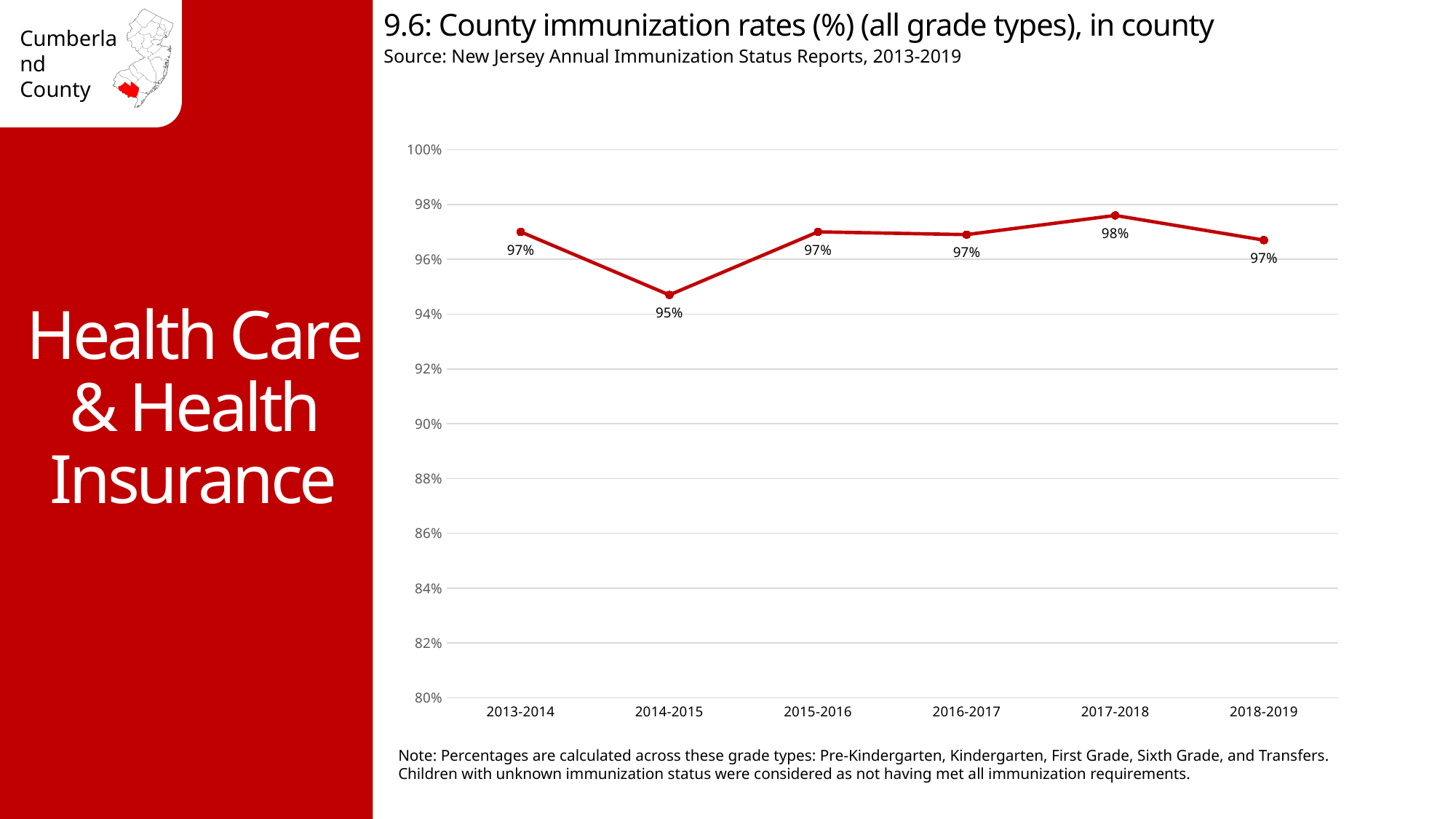
Does the immunization rate rise or fall from 2013-2014 to 2014-2015? fall Which school year has the highest immunization rate? 2017-2018 Which school year has the lowest immunization rate? 2014-2015 What kind of chart is shown on the slide? line chart Is the immunization rate for 2014-2015 greater or less than 96%? less What is the county immunization rate for 2017-2018? 98% What is the county immunization rate for 2013-2014? 97% What is the difference between the immunization rate in 2017-2018 and in 2014-2015? 3 percentage points How many school years are plotted on the chart? 6 What is the county immunization rate for 2014-2015? 95% Which is larger, the immunization rate in 2014-2015 or in 2017-2018? 2017-2018 What is the source cited for the chart? New Jersey Annual Immunization Status Reports, 2013-2019